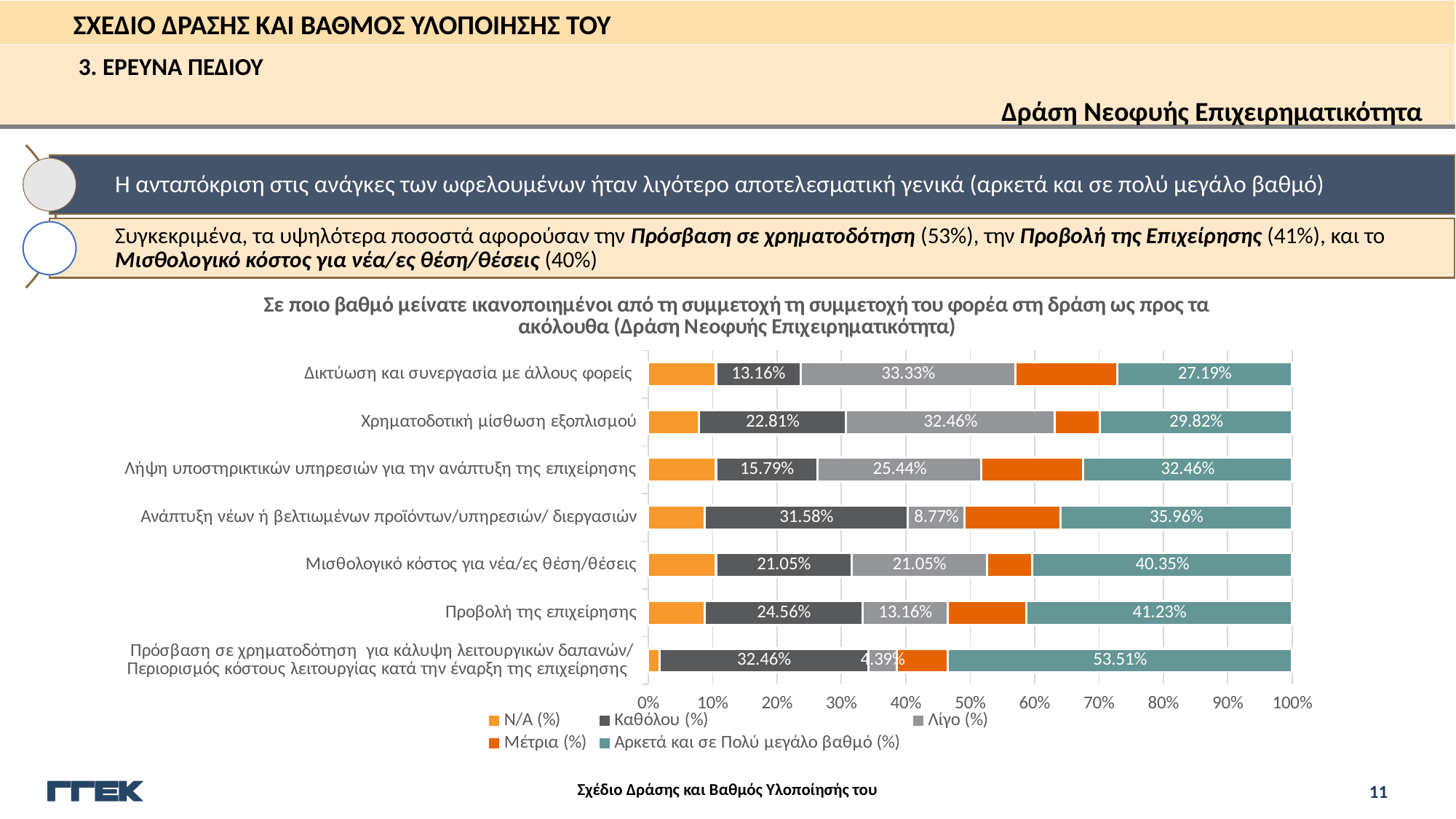
Which category has the highest value for 'Αρκετά και σε Πολύ μεγάλο βαθμό (%)'? Πρόσβαση σε χρηματοδότηση για κάλυψη λειτουργικών δαπανών/ Περιορισμός κόστους λειτουργίας κατά την έναρξη της επιχείρησης What is the value of 'Καθόλου (%)' for 'Χρηματοδοτική μίσθωση εξοπλισμού'? 22.81% What is the value of 'Λίγο (%)' for 'Δικτύωση και συνεργασία με άλλους φορείς'? 33.33% Which category has the lowest value for 'Λίγο (%)'? Πρόσβαση σε χρηματοδότηση για κάλυψη λειτουργικών δαπανών/ Περιορισμός κόστους λειτουργίας κατά την έναρξη της επιχείρησης Which has the larger 'Καθόλου (%)' value: 'Ανάπτυξη νέων ή βελτιωμένων προϊόντων/υπηρεσιών/ διεργασιών' or 'Μισθολογικό κόστος για νέα/ες θέση/θέσεις'? Ανάπτυξη νέων ή βελτιωμένων προϊόντων/υπηρεσιών/ διεργασιών How many categories are plotted on the chart? 7 How many series does the legend list? 5 What kind of chart is shown on the slide? Bar chart Which category has the highest value for 'Καθόλου (%)'? Πρόσβαση σε χρηματοδότηση για κάλυψη λειτουργικών δαπανών/ Περιορισμός κόστους λειτουργίας κατά την έναρξη της επιχείρησης What colour represents the 'Αρκετά και σε Πολύ μεγάλο βαθμό (%)' series in the legend? Teal What is the value of 'Αρκετά και σε Πολύ μεγάλο βαθμό (%)' for 'Προβολή της επιχείρησης'? 41.23% What is the difference between the 'Αρκετά και σε Πολύ μεγάλο βαθμό (%)' values for 'Πρόσβαση σε χρηματοδότηση...' and 'Προβολή της επιχείρησης'? 12.28 percentage points